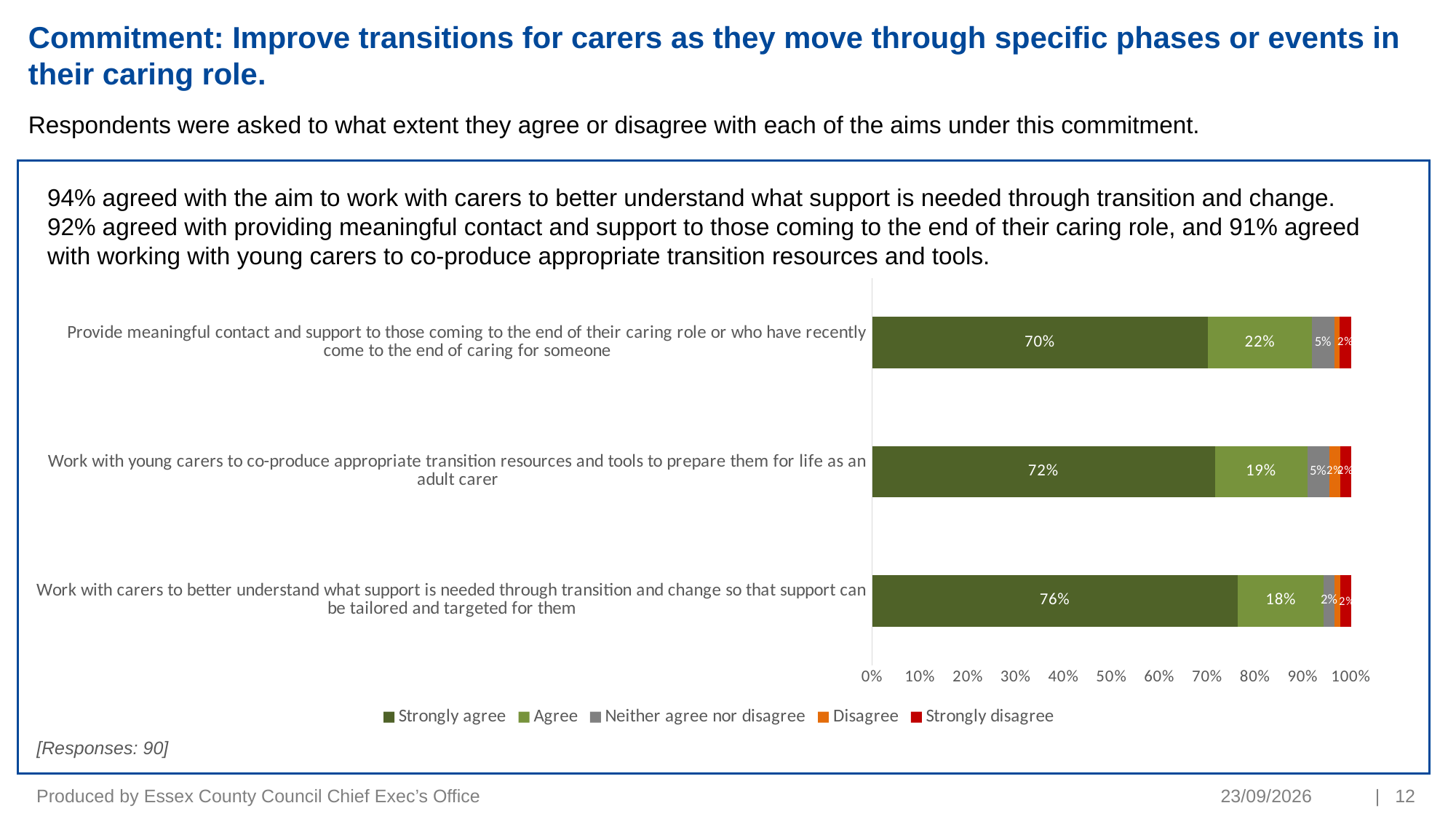
Which colour represents 'Strongly disagree' in the chart legend? Red What is the difference in 'Strongly agree' percentage between the aim to work with carers to better understand what support is needed (76%) and the aim to provide meaningful contact and support to those ending their caring role (70%)? 6 percentage points What percentage of respondents strongly agreed with the aim to work with carers to better understand what support is needed through transition and change? 76% How many series does the chart legend list? 5 Which aim has a higher 'Strongly agree' percentage: working with young carers to co-produce transition resources, or providing meaningful contact and support to those coming to the end of their caring role? Work with young carers to co-produce appropriate transition resources and tools Which aim has the highest 'Strongly agree' percentage? Work with carers to better understand what support is needed through transition and change so that support can be tailored and targeted for them What percentage of respondents selected 'Agree' for the aim to work with young carers to co-produce appropriate transition resources and tools? 19% What percentage of respondents selected 'Agree' for the aim to provide meaningful contact and support to those coming to the end of their caring role? 22% How many aims (categories) are plotted in the chart? 3 Which aim has the lowest 'Strongly agree' percentage? Provide meaningful contact and support to those coming to the end of their caring role or who have recently come to the end of caring for someone What kind of chart is shown on the slide? Bar chart What percentage of respondents selected 'Neither agree nor disagree' for the aim to work with young carers to co-produce appropriate transition resources and tools? 5%